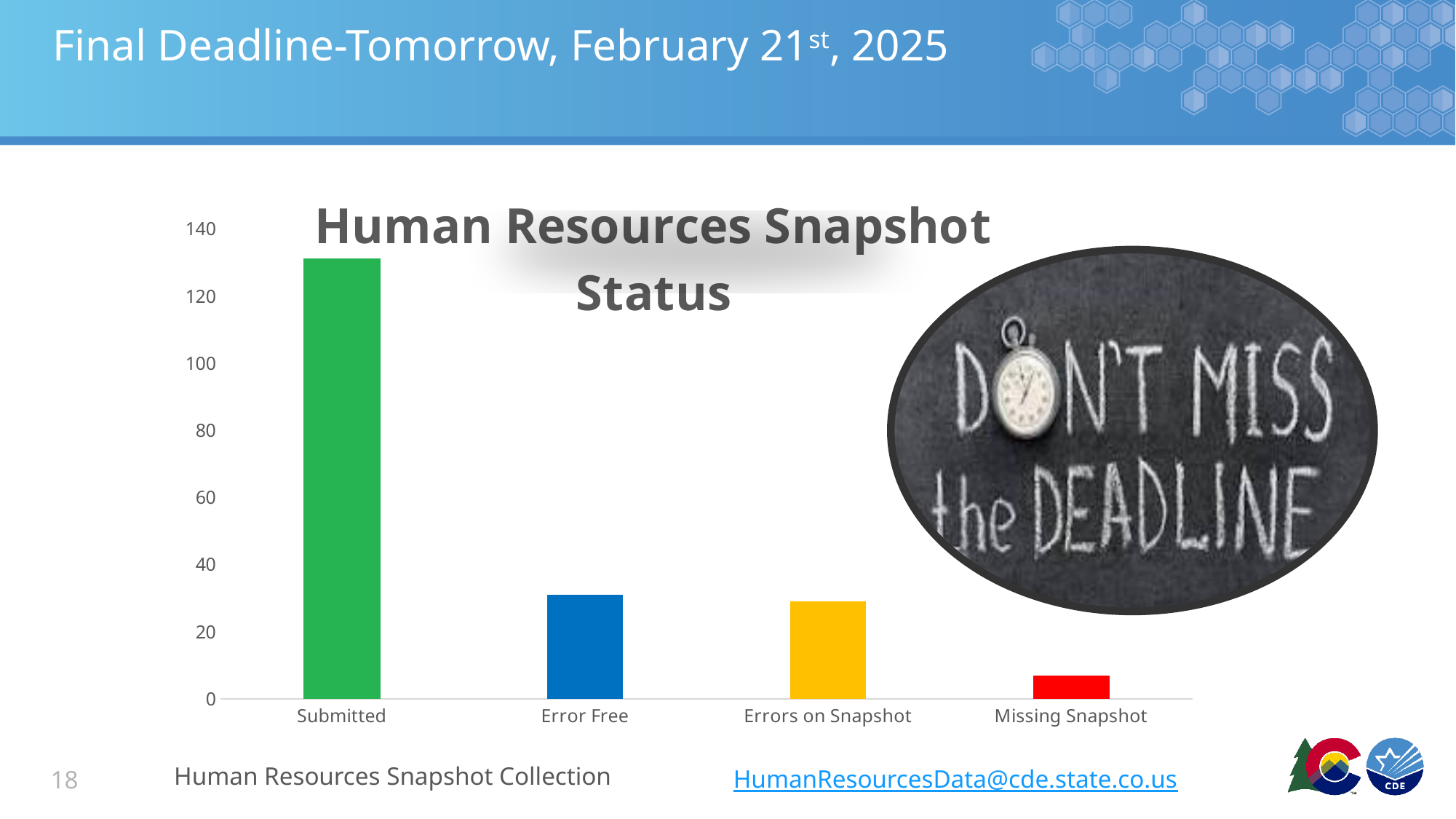
Is the value for Errors on Snapshot greater or less than 20? greater Which category has the highest value in the chart? Submitted What type of chart is shown on the slide? bar chart Is the value for Submitted greater or less than 120? greater How many categories are shown on the x axis of the chart? 4 Is the value for Missing Snapshot greater or less than 20? less Which is larger, the value for Errors on Snapshot or the value for Missing Snapshot? Errors on Snapshot What colour is the bar for Missing Snapshot? red Which category has the lowest value in the chart? Missing Snapshot Which is larger, the value for Submitted or the value for Error Free? Submitted What is the title of the chart? Human Resources Snapshot Status